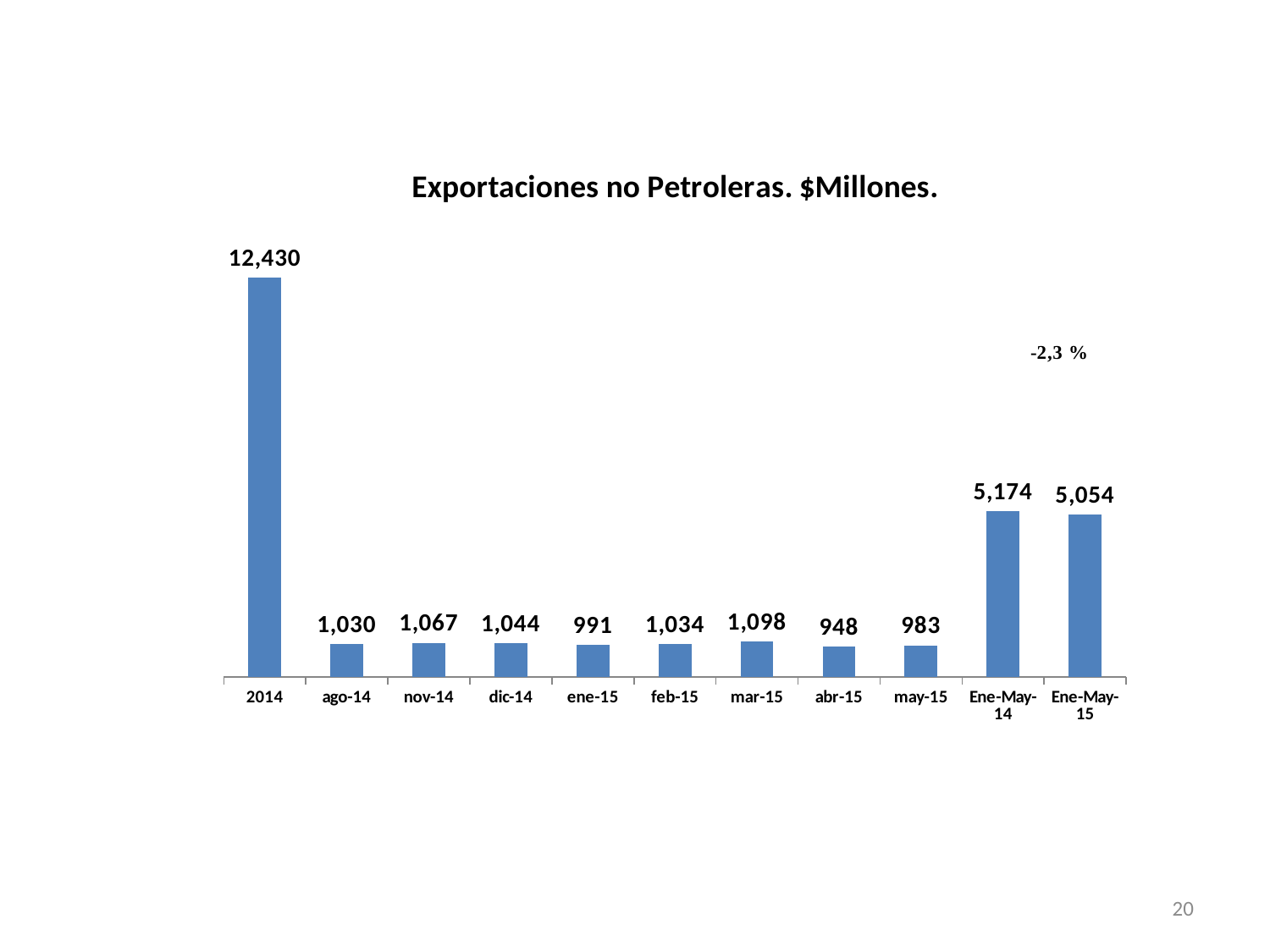
How many categories are shown on the x axis? 11 Which category has the highest value? 2014 What is the difference between mar-15 and abr-15? 150 Which is larger, the value for nov-14 or the value for dic-14? nov-14 What is the value for mar-15? 1,098 What is the value for Ene-May-15? 5,054 What is the title of the chart? Exportaciones no Petroleras. $Millones. What kind of chart is this? bar chart What is the value for abr-15? 948 What is the value for 2014? 12,430 Which category has the lowest value? abr-15 What is the difference between Ene-May-14 and Ene-May-15? 120